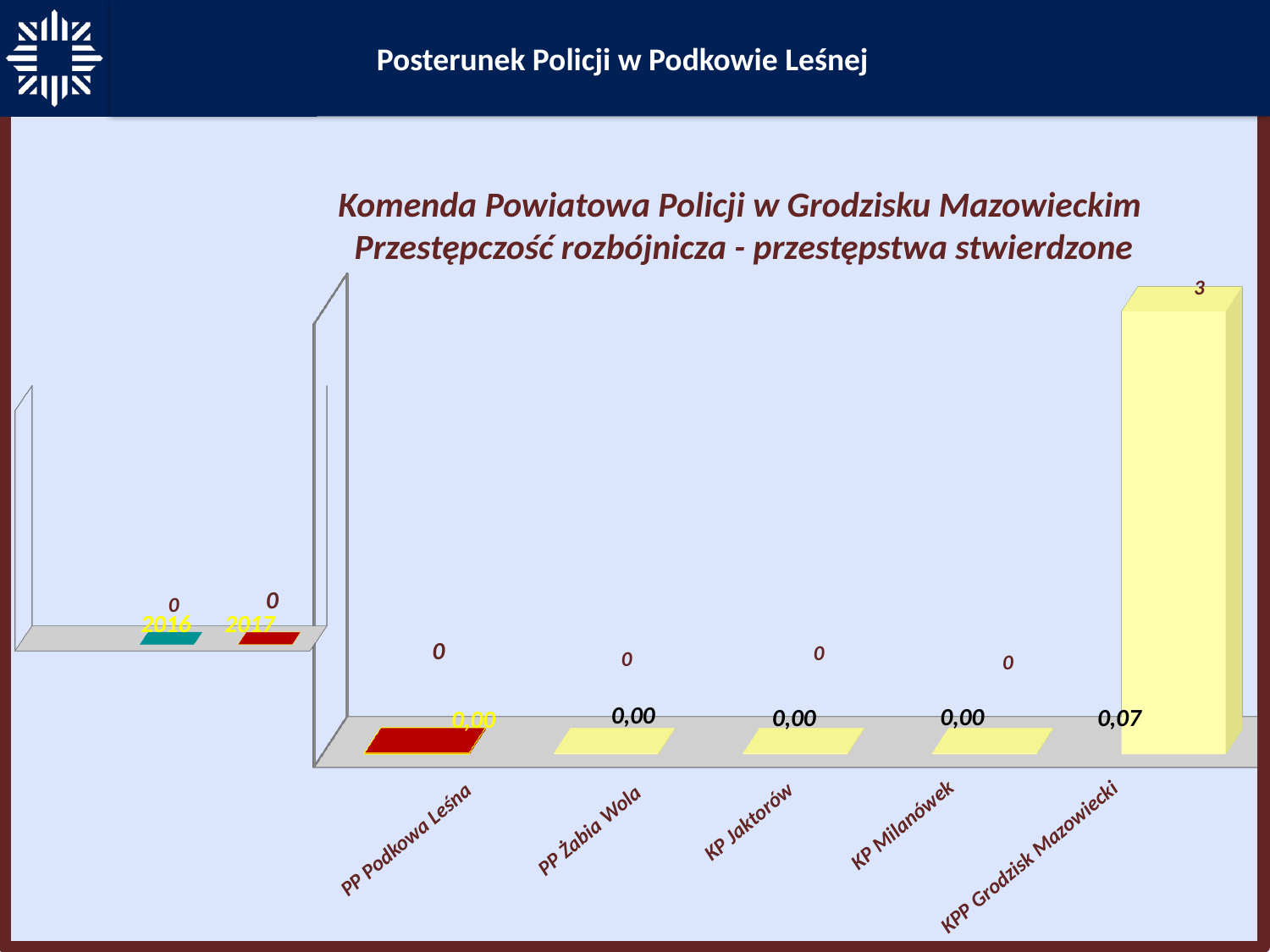
In the large chart titled 'Przestępczość rozbójnicza - przestępstwa stwierdzone', what value is labelled above the bar for KPP Grodzisk Mazowiecki? 3 What type of chart is the large chart titled 'Przestępczość rozbójnicza - przestępstwa stwierdzone'? bar chart In the large chart titled 'Przestępczość rozbójnicza - przestępstwa stwierdzone', which unit has the highest value? KPP Grodzisk Mazowiecki In the large chart titled 'Przestępczość rozbójnicza - przestępstwa stwierdzone', what is the difference between the value for KPP Grodzisk Mazowiecki and the value for KP Milanówek? 3 In the small chart on the left of the slide, how many years are shown? 2 In the large chart titled 'Przestępczość rozbójnicza - przestępstwa stwierdzone', what value is labelled above the bar for PP Podkowa Leśna? 0 In the large chart titled 'Przestępczość rozbójnicza - przestępstwa stwierdzone', what value is labelled above the bar for KP Jaktorów? 0 In the large chart titled 'Przestępczość rozbójnicza - przestępstwa stwierdzone', how many police units are shown on the x axis? 5 In the large chart titled 'Przestępczość rozbójnicza - przestępstwa stwierdzone', which is larger: the value for KPP Grodzisk Mazowiecki or the value for PP Żabia Wola? KPP Grodzisk Mazowiecki In the small chart on the left of the slide, what value is labelled for 2017? 0 In the large chart titled 'Przestępczość rozbójnicza - przestępstwa stwierdzone', what decimal value is printed at the base of the KPP Grodzisk Mazowiecki bar? 0,07 In the small chart on the left of the slide, what value is labelled for 2016? 0